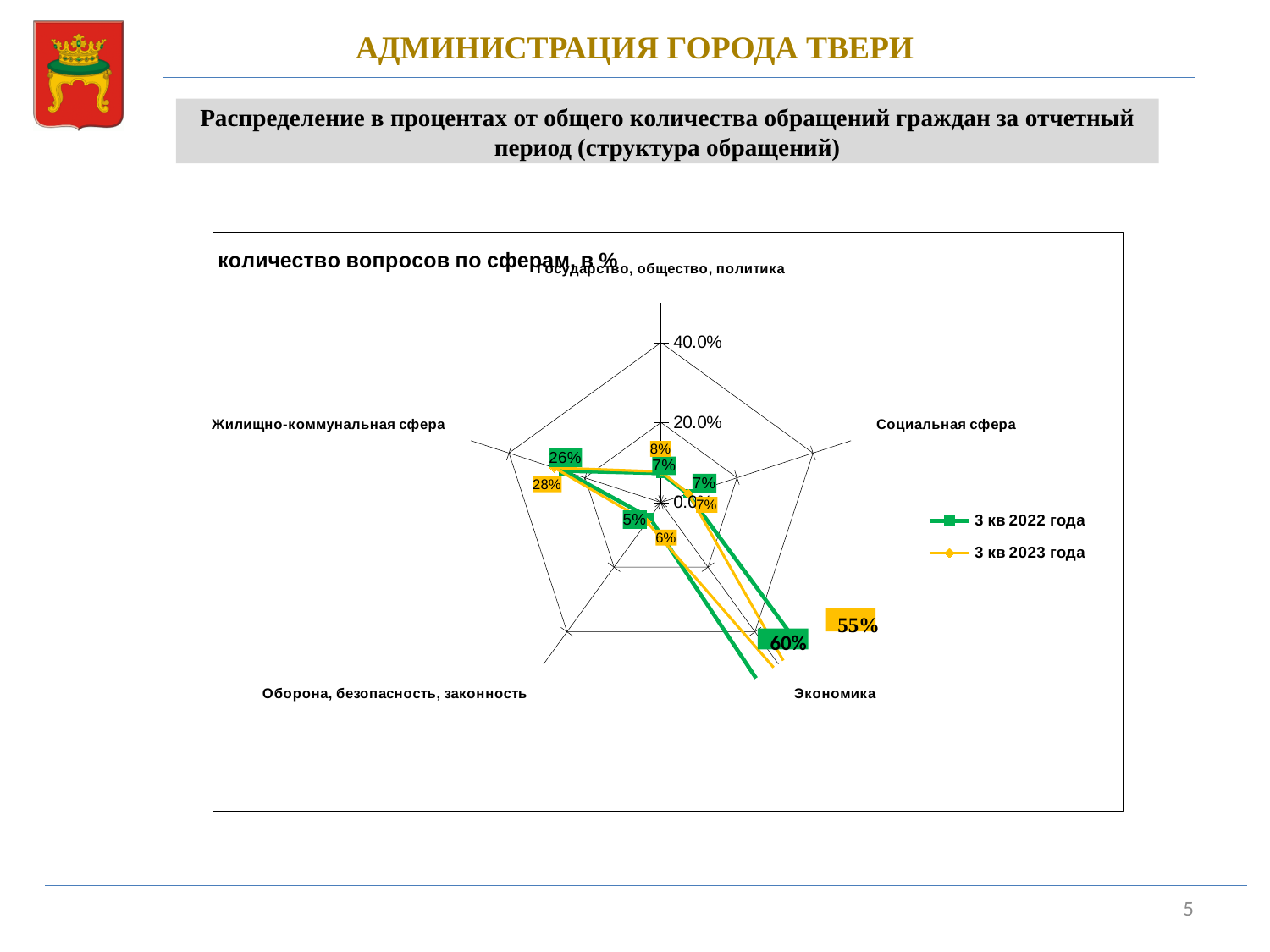
What is the title of the chart? количество вопросов по сферам, в % What is the value for Экономика in the series 3 кв 2022 года? 60% What kind of chart is shown on the slide? Radar chart What is the value for Оборона, безопасность, законность in the series 3 кв 2022 года? 5% What is the value for Жилищно-коммунальная сфера in the series 3 кв 2023 года? 28% What is the value for Экономика in the series 3 кв 2023 года? 55% Which category has the lowest value in the series 3 кв 2022 года? Оборона, безопасность, законность For Жилищно-коммунальная сфера, which series has the larger value: 3 кв 2022 года or 3 кв 2023 года? 3 кв 2023 года How many categories (spheres) are plotted on the radar chart? 5 What is the difference between the 3 кв 2022 года and 3 кв 2023 года values for Экономика? 5% Which category has the highest value in the series 3 кв 2022 года? Экономика How many series does the legend list? 2